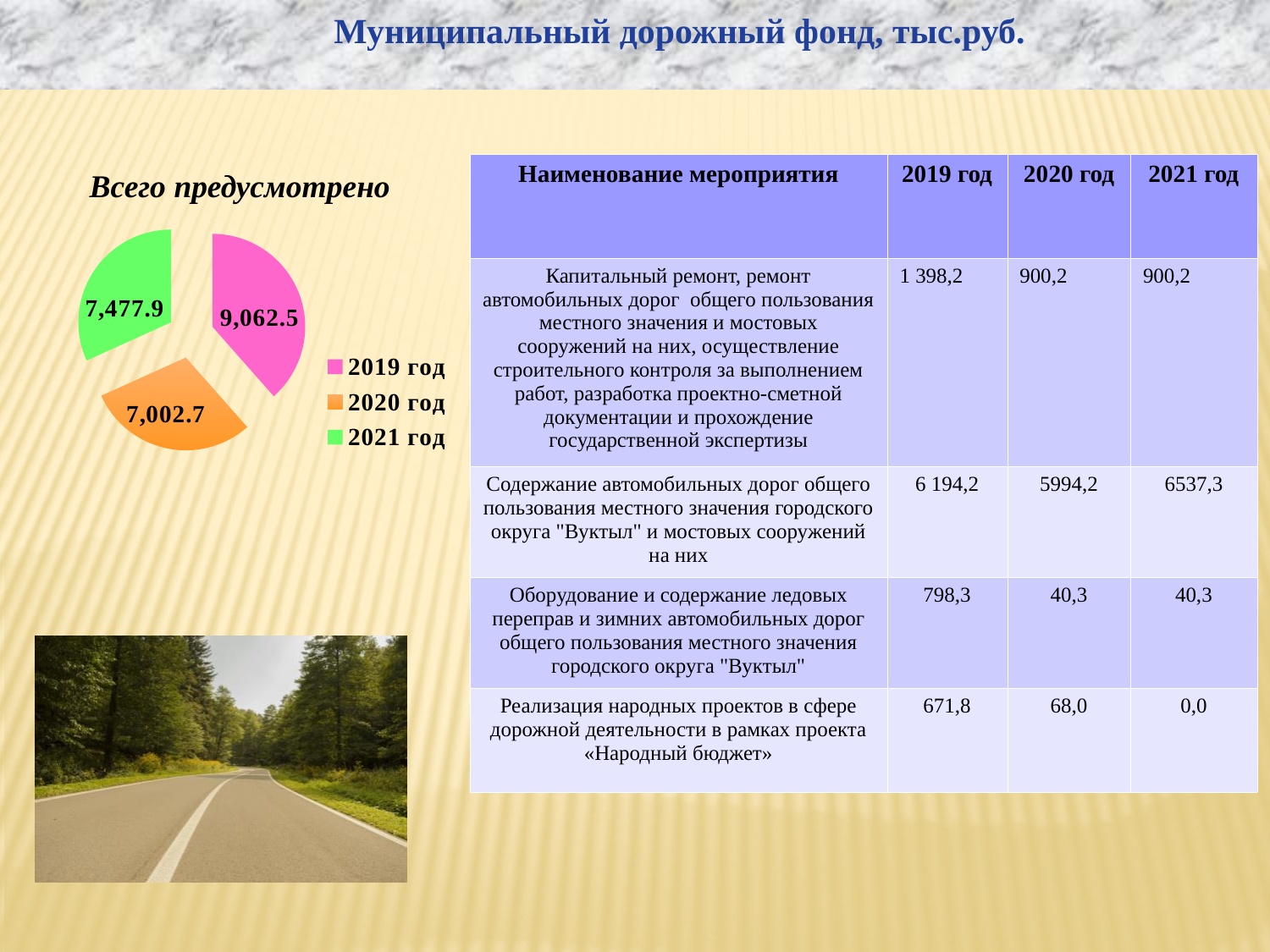
How many slices does the pie chart have? 3 Which is larger in the pie chart, the value for 2020 год or for 2021 год? 2021 год What is the title of the pie chart? Всего предусмотрено What value is shown for 2019 год in the pie chart? 9,062.5 What is the difference between the 2019 год and 2020 год values in the pie chart? 2,059.8 Which year has the largest slice in the pie chart? 2019 год What value is shown for 2020 год in the pie chart? 7,002.7 What type of chart is shown on the slide? Pie chart What share of the pie chart does the 2019 год slice represent? 38.5% Which year has the smallest slice in the pie chart? 2020 год What value is shown for 2021 год in the pie chart? 7,477.9 How many entries does the pie chart's legend list? 3